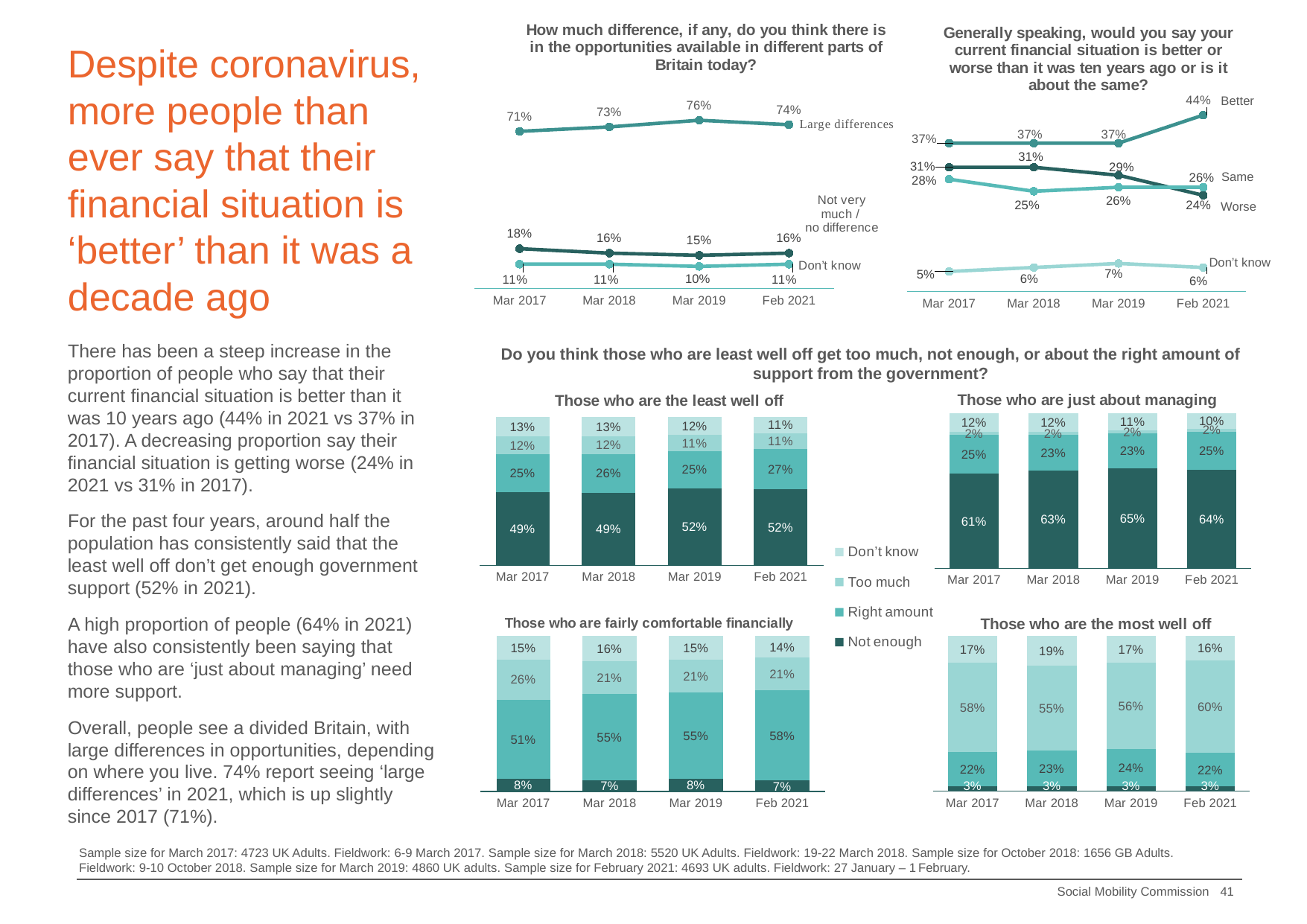
In the chart titled 'Those who are fairly comfortable financially', what is the 'Right amount' value for Mar 2018? 55% In the chart titled 'Generally speaking, would you say your current financial situation is better or worse than it was ten years ago or is it about the same?', how many time points are shown on the x axis? 4 In the chart titled 'How much difference, if any, do you think there is in the opportunities available in different parts of Britain today?', what kind of chart is it? Line chart In the chart titled 'Generally speaking, would you say your current financial situation is better or worse than it was ten years ago or is it about the same?', what is the difference between 'Worse' in Mar 2017 and 'Worse' in Feb 2021? 7% In the chart titled 'Those who are the most well off', what is the 'Too much' value for Feb 2021? 60% In the chart titled 'Those who are just about managing', in which period is 'Not enough' highest? Mar 2019 How many series does the shared legend for the stacked bar charts list? 4 In the chart titled 'Generally speaking, would you say your current financial situation is better or worse than it was ten years ago or is it about the same?', what is the value for 'Better' in Feb 2021? 44% In the chart titled 'Generally speaking, would you say your current financial situation is better or worse than it was ten years ago or is it about the same?', in which period is 'Don't know' highest? Mar 2019 In the chart titled 'Those who are the least well off', what is the 'Not enough' value for Feb 2021? 52% In the chart titled 'How much difference, if any, do you think there is in the opportunities available in different parts of Britain today?', what is the value for 'Large differences' in Mar 2019? 76% In the chart titled 'Those who are the least well off', which is larger: 'Right amount' in Mar 2017 or 'Right amount' in Feb 2021? Feb 2021